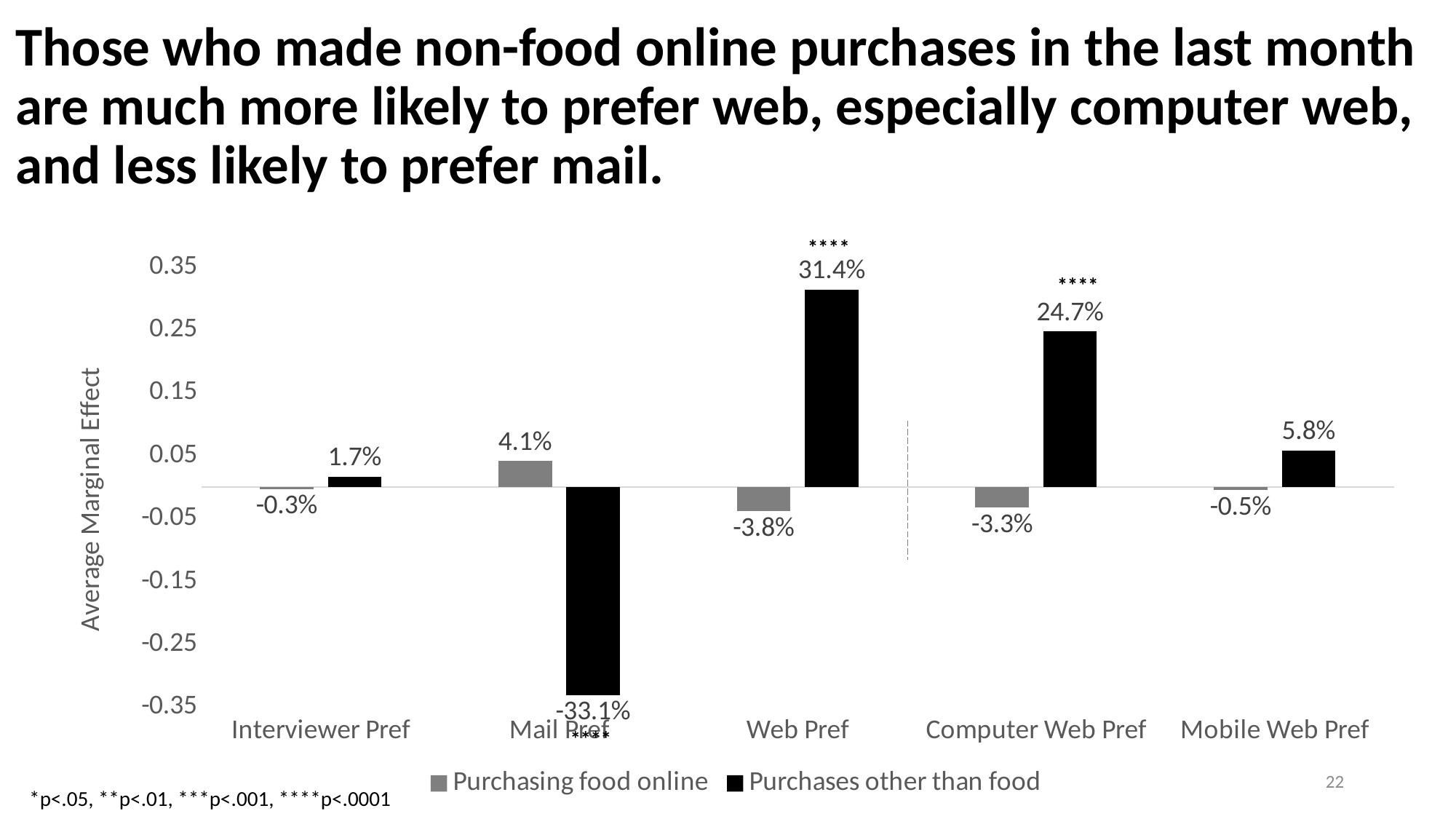
What is the label of the vertical axis? Average Marginal Effect Which category has the lowest value for Purchases other than food? Mail Pref What kind of chart is shown on the slide? Bar chart Which category has the highest value for Purchases other than food? Web Pref What is the value for Purchasing food online for Mail Pref? 4.1% What is the value for Purchases other than food for Web Pref? 31.4% What is the value for Purchasing food online for Computer Web Pref? -3.3% What is the value for Purchases other than food for Mail Pref? -33.1% How many series does the legend list? 2 How many categories are shown on the x axis? 5 What is the difference between the Purchases other than food values for Web Pref and Computer Web Pref? 6.7% Which is larger for Mobile Web Pref: Purchasing food online or Purchases other than food? Purchases other than food